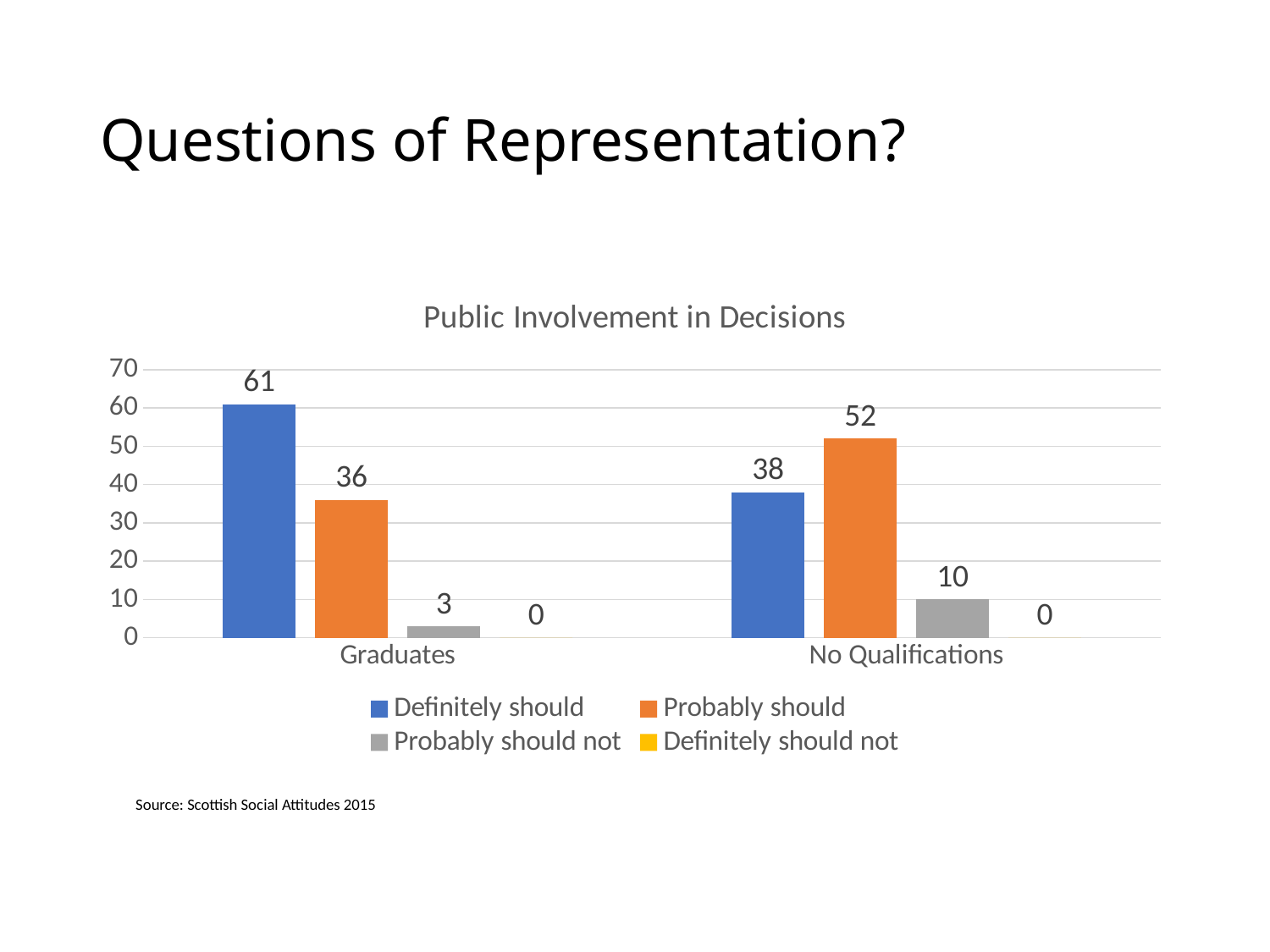
What is the value for 'Probably should not' among No Qualifications? 10 What is the value for 'Definitely should not' among Graduates? 0 What is the title of the chart? Public Involvement in Decisions What kind of chart is shown? Bar chart Which series has the highest value for Graduates? Definitely should Which series has the highest value for No Qualifications? Probably should What is the value for 'Probably should' among No Qualifications? 52 How many categories are shown on the x axis? 2 How many series does the legend list? 4 What is the value for 'Definitely should' among Graduates? 61 What is the difference between 'Definitely should' for Graduates and for No Qualifications? 23 Which is larger: 'Probably should' for Graduates or 'Probably should' for No Qualifications? No Qualifications